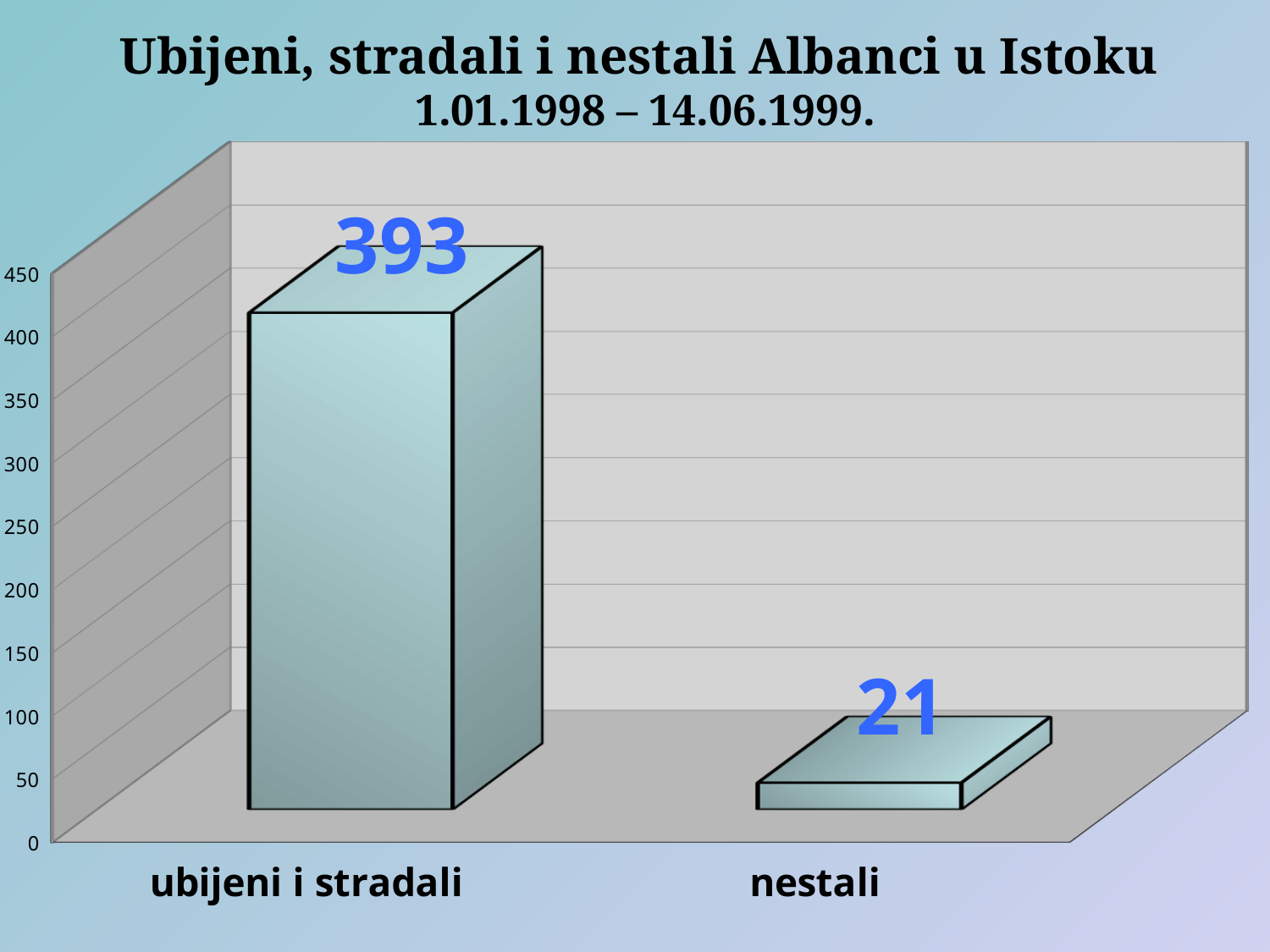
Which category has the highest value? ubijeni i stradali What kind of chart is shown on the slide? bar chart What is the value for "ubijeni i stradali"? 393 What is the value for "nestali"? 21 Is the value for "ubijeni i stradali" greater or less than 300? greater Which is larger, the value for "ubijeni i stradali" or the value for "nestali"? ubijeni i stradali How many categories are shown in the chart? 2 What is the highest value shown on the vertical axis? 450 What is the title of the chart? Ubijeni, stradali i nestali Albanci u Istoku 1.01.1998 – 14.06.1999. Which category has the lowest value? nestali What is the difference between the values for "ubijeni i stradali" and "nestali"? 372 Is the value for "nestali" greater or less than 100? less